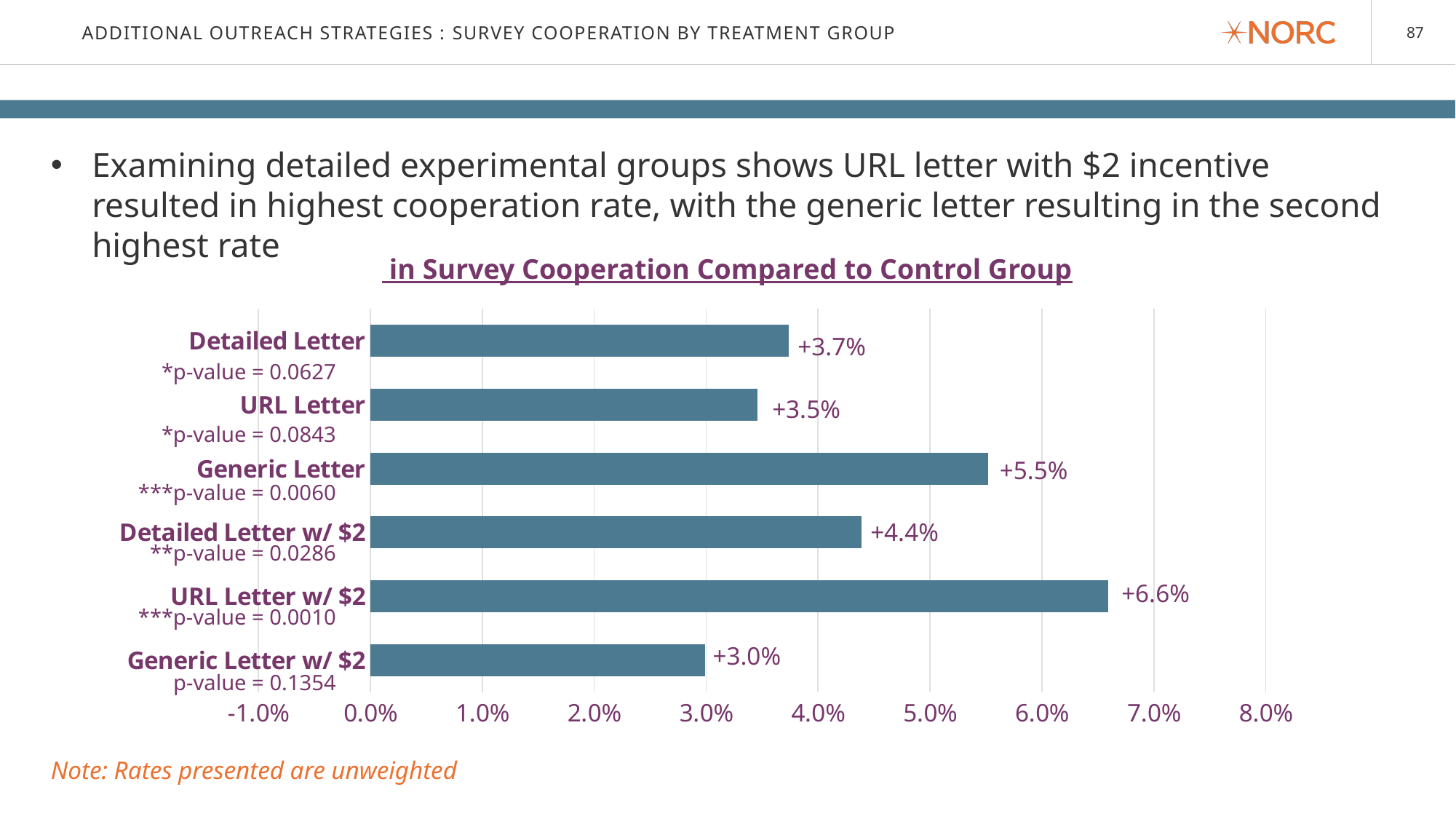
What kind of chart is shown on the slide? bar chart What is the difference between the values for URL Letter w/ $2 and Generic Letter? 1.1% What is the value shown for Generic Letter? +5.5% What is the value shown for URL Letter w/ $2? +6.6% Which is larger, the value for Detailed Letter or the value for URL Letter? Detailed Letter Is the value for Detailed Letter w/ $2 greater or less than 4.0%? greater What is the value shown for Detailed Letter w/ $2? +4.4% How many categories are shown in the chart? 6 What is the value shown for Generic Letter w/ $2? +3.0% What p-value is listed under URL Letter w/ $2? 0.0010 Which category has the lowest value? Generic Letter w/ $2 Which category has the highest value? URL Letter w/ $2